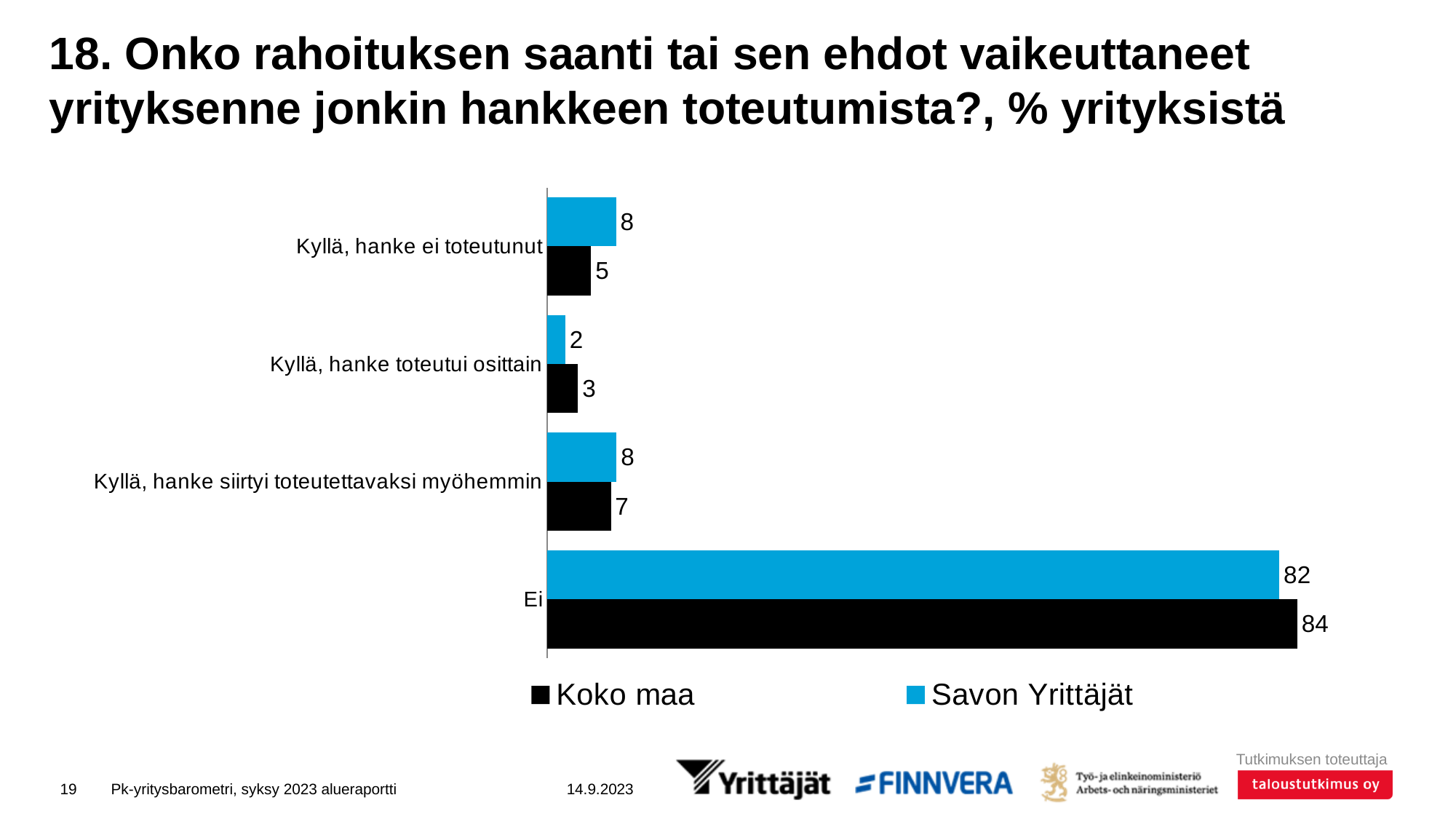
What is the value for Savon Yrittäjät in the category "Kyllä, hanke toteutui osittain"? 2 What is the value for Koko maa in the category "Kyllä, hanke ei toteutunut"? 5 What kind of chart is shown on the slide? Bar chart How many series does the legend list? 2 What is the value for Koko maa in the category "Kyllä, hanke siirtyi toteutettavaksi myöhemmin"? 7 What is the difference between the Koko maa and Savon Yrittäjät values in the category "Ei"? 2 Which category has the highest value for Koko maa? Ei Which category has the lowest value for Savon Yrittäjät? Kyllä, hanke toteutui osittain In the category "Kyllä, hanke ei toteutunut", which series has the larger value, Koko maa or Savon Yrittäjät? Savon Yrittäjät How many categories are shown on the chart? 4 What is the value for Savon Yrittäjät in the category "Ei"? 82 Which colour represents the Savon Yrittäjät series? Blue